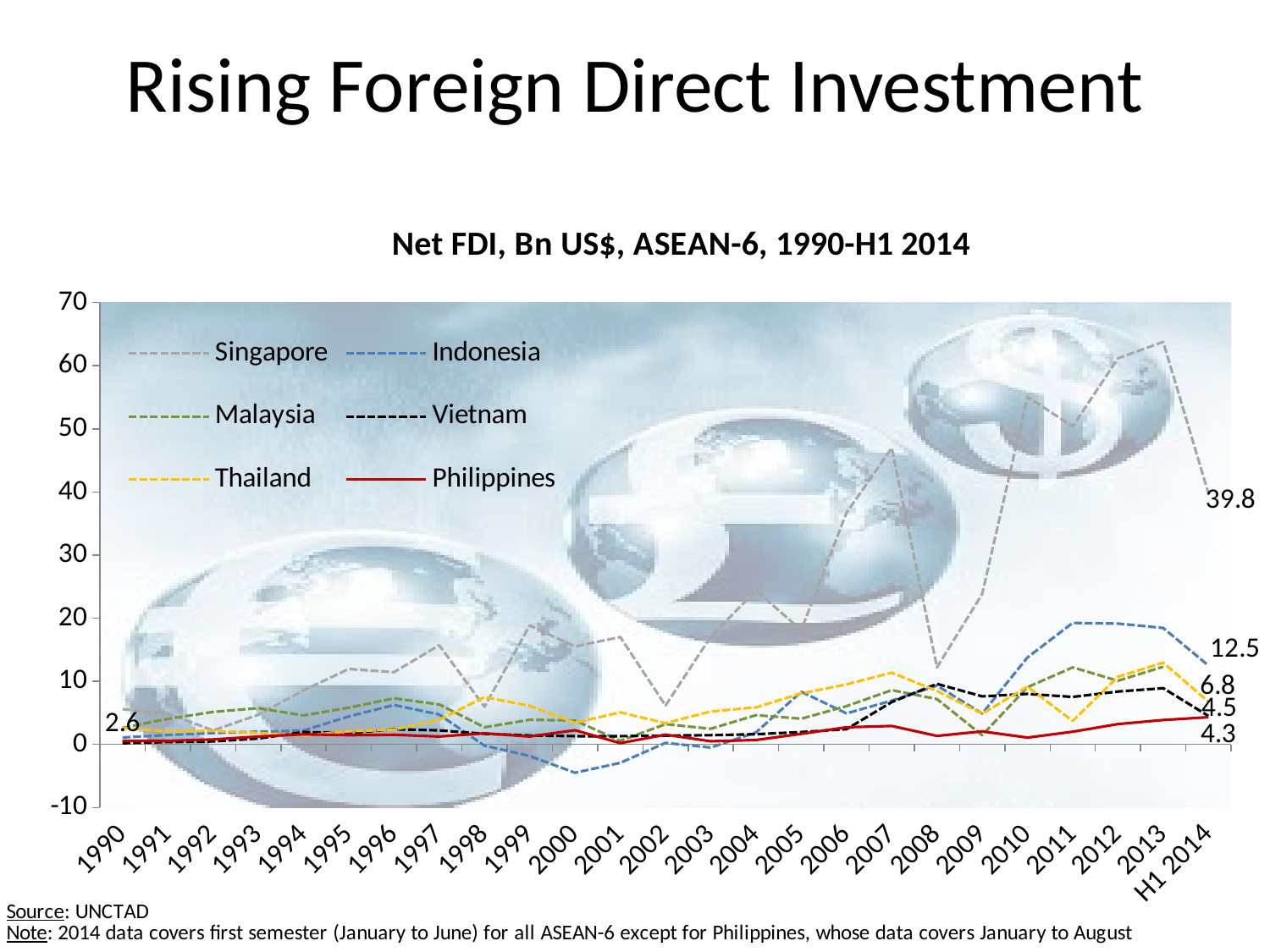
What is the net FDI value for Singapore in H1 2014? 39.8 What kind of chart is shown on the slide? line chart What is the title of the chart? Net FDI, Bn US$, ASEAN-6, 1990-H1 2014 What is the difference between Singapore's and Indonesia's net FDI in H1 2014? 27.3 Is the value for Singapore in 2013 greater or less than 50? greater Is the value for Indonesia in 2000 greater or less than 0? less Which is larger in H1 2014, the value for Singapore or the value for Indonesia? Singapore How many time periods are shown on the x axis of the chart? 25 What is the net FDI value for Indonesia in H1 2014? 12.5 Which country has the highest net FDI in H1 2014? Singapore Is the value for Singapore in 2008 greater or less than 20? less How many series does the chart's legend list? 6